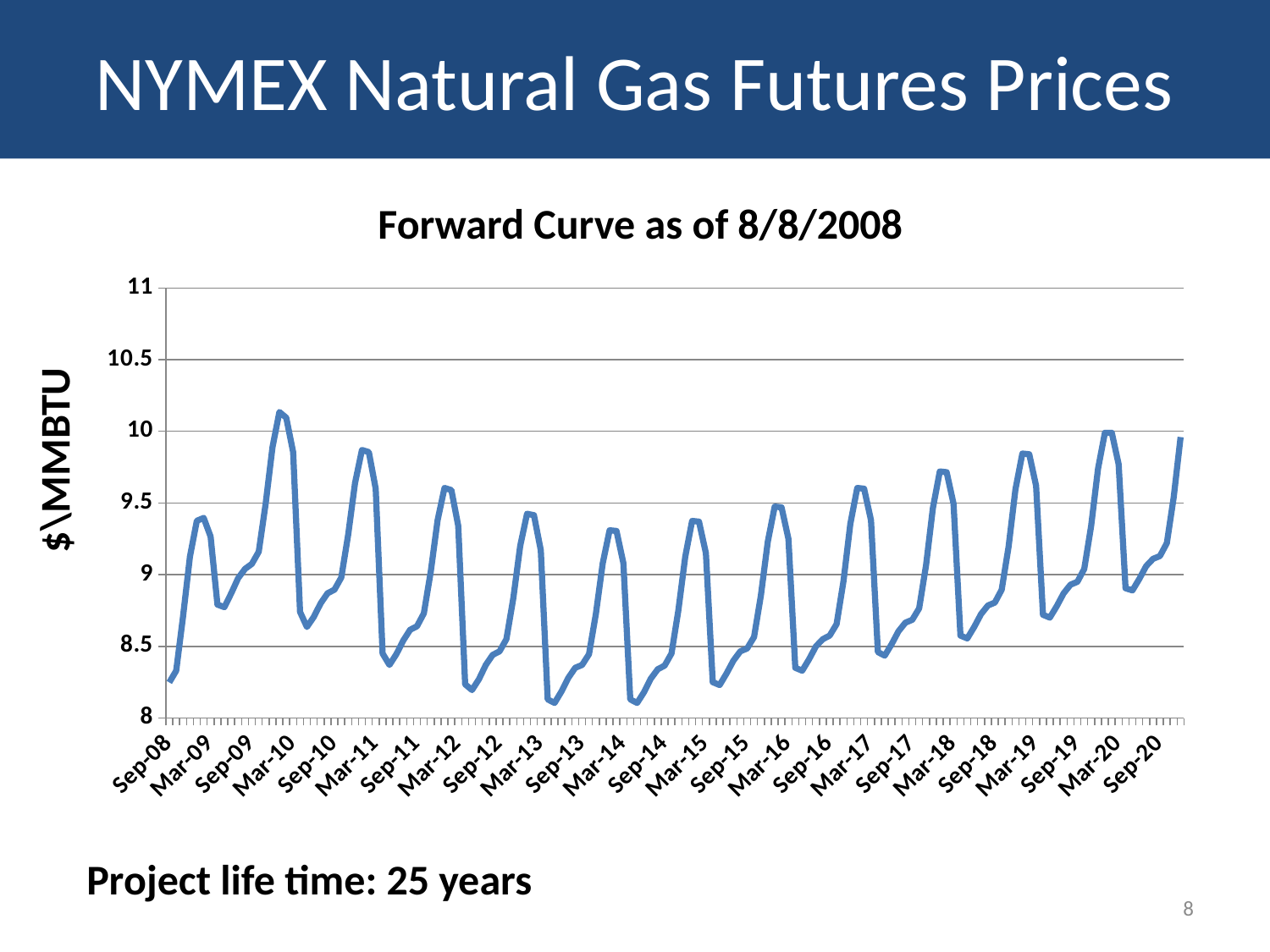
Around which x-axis label does the chart reach its highest value? Mar-10 What kind of chart is shown on the slide? line chart Is the value at Sep-08 greater or less than 8.5? less Do the seasonal peaks rise or fall from Mar-14 to Mar-20? rise How many data series are plotted on the chart? 1 What is the label on the vertical axis of the chart? $\MMBTU How many labels are shown on the horizontal axis of the chart? 25 Is the lowest value on the chart greater or less than 8.5? less What is the title of the chart? Forward Curve as of 8/8/2008 Is the peak value near Mar-14 greater or less than 9.5? less Which is larger, the peak near Mar-10 or the peak near Mar-14? the peak near Mar-10